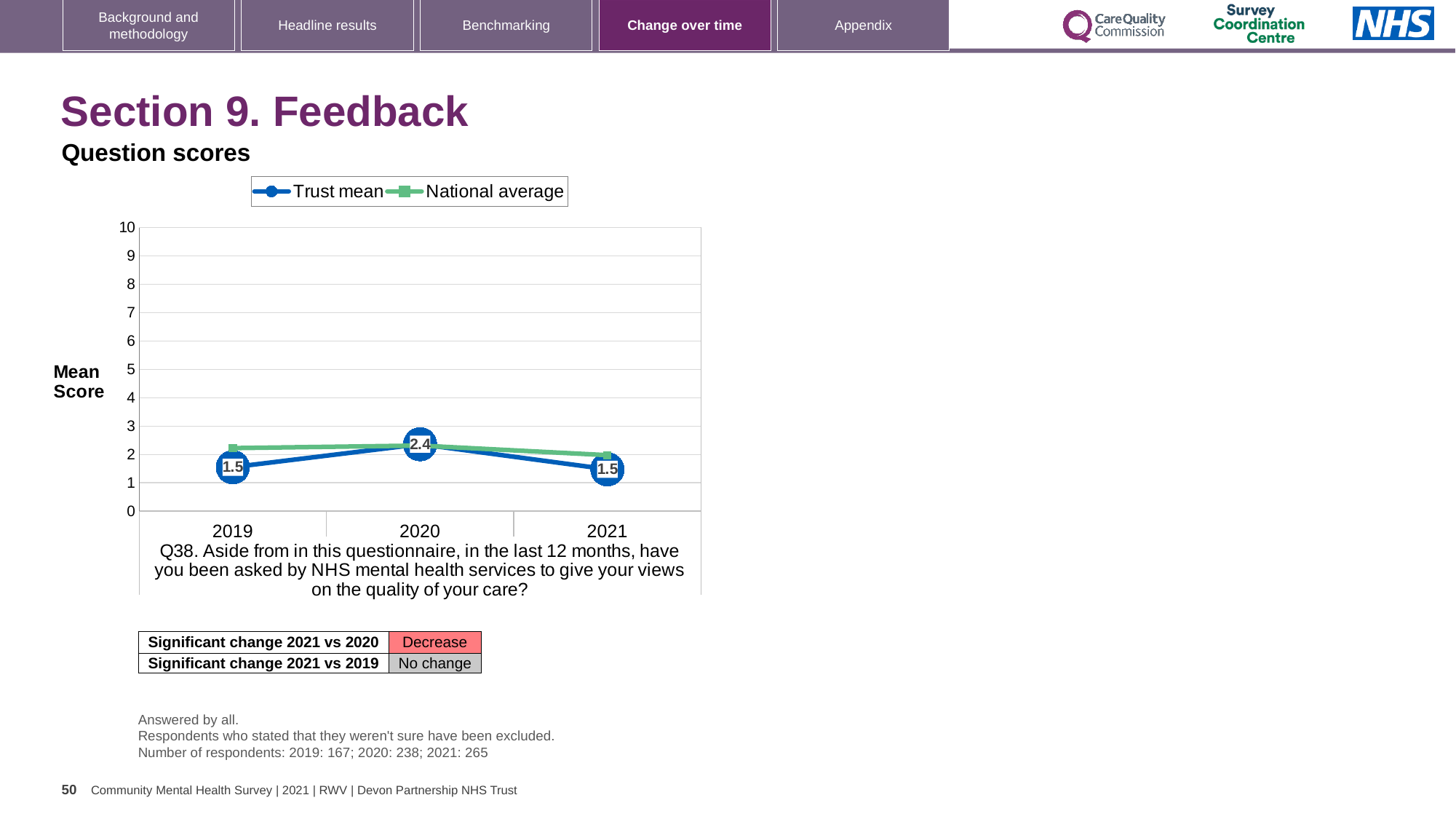
Does the Trust mean score rise or fall from 2020 to 2021? fall How many years are shown on the x axis of the chart? 3 What kind of chart is shown on the slide? line chart Is the National average value for 2019 greater or less than 3? less What is the Trust mean score for 2019? 1.5 What is the difference between the Trust mean score in 2020 and in 2019? 0.9 How many series does the legend list? 2 In which year is the Trust mean score highest? 2020 What is the Trust mean score for 2021? 1.5 In 2019, which series has the higher value, Trust mean or National average? National average Which is larger, the Trust mean score in 2020 or in 2021? 2020 What is the Trust mean score for 2020? 2.4